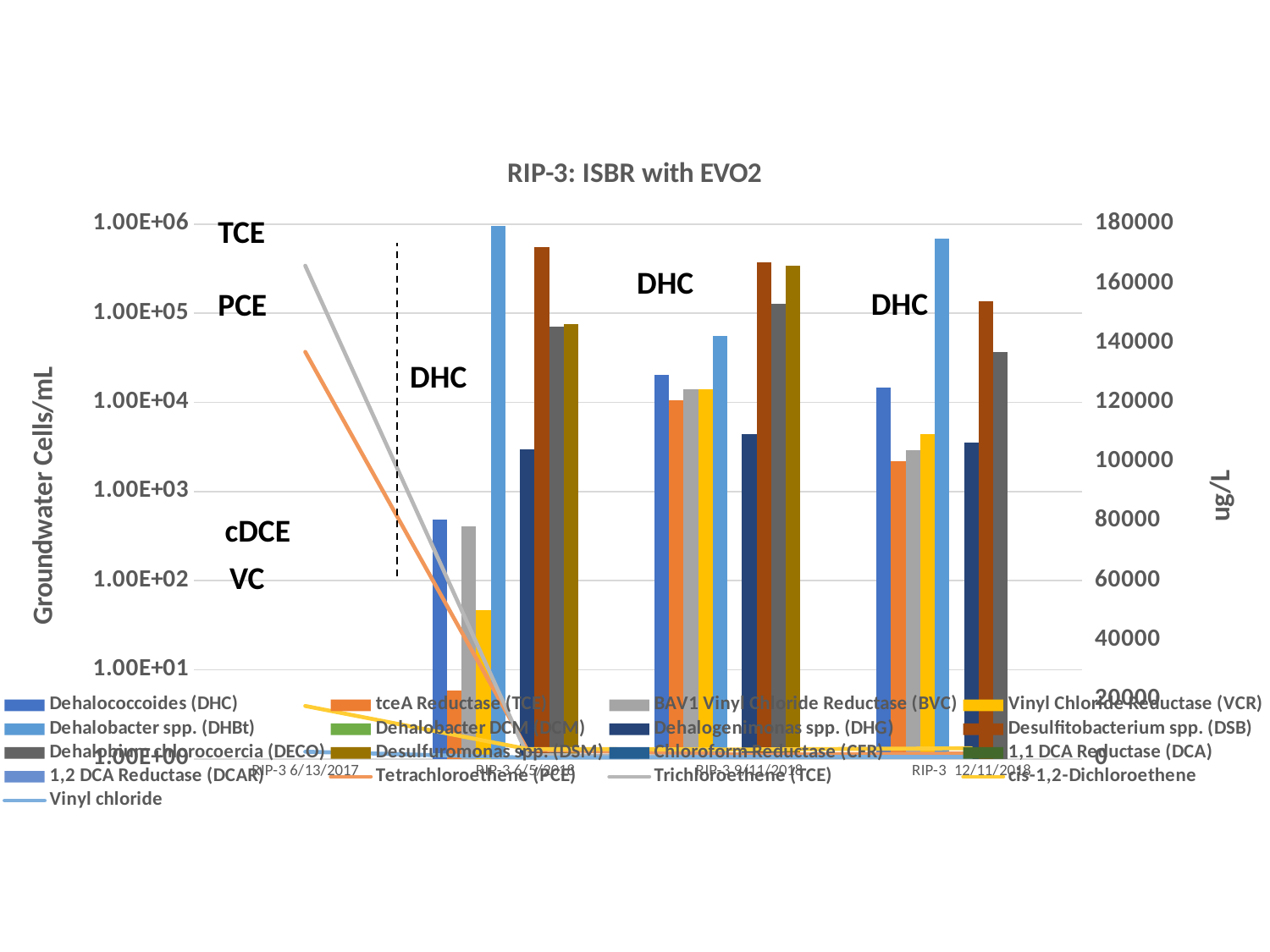
How many series does the legend list? 17 How many sampling dates (categories) are shown along the x axis? 4 What is the label of the left vertical axis? Groundwater Cells/mL Does the Trichloroethene (TCE) line rise or fall from RIP-3 6/13/2017 to RIP-3 6/5/2018? Fall What is the title of the chart? RIP-3: ISBR with EVO2 Is the value for Dehalococcoides (DHC) at RIP-3 9/11/2018 greater or less than 1.00E+04? greater Is the value for Dehalococcoides (DHC) at RIP-3 6/5/2018 greater or less than 1.00E+03? less Which is larger: Dehalococcoides (DHC) at RIP-3 6/5/2018 or at RIP-3 9/11/2018? RIP-3 9/11/2018 Is the value for Desulfitobacterium spp. (DSB) at RIP-3 6/5/2018 greater or less than 1.00E+05? greater What kind of chart is shown on the slide? Combination bar and line chart Which is larger: Desulfitobacterium spp. (DSB) at RIP-3 6/5/2018 or at RIP-3 12/11/2018? RIP-3 6/5/2018